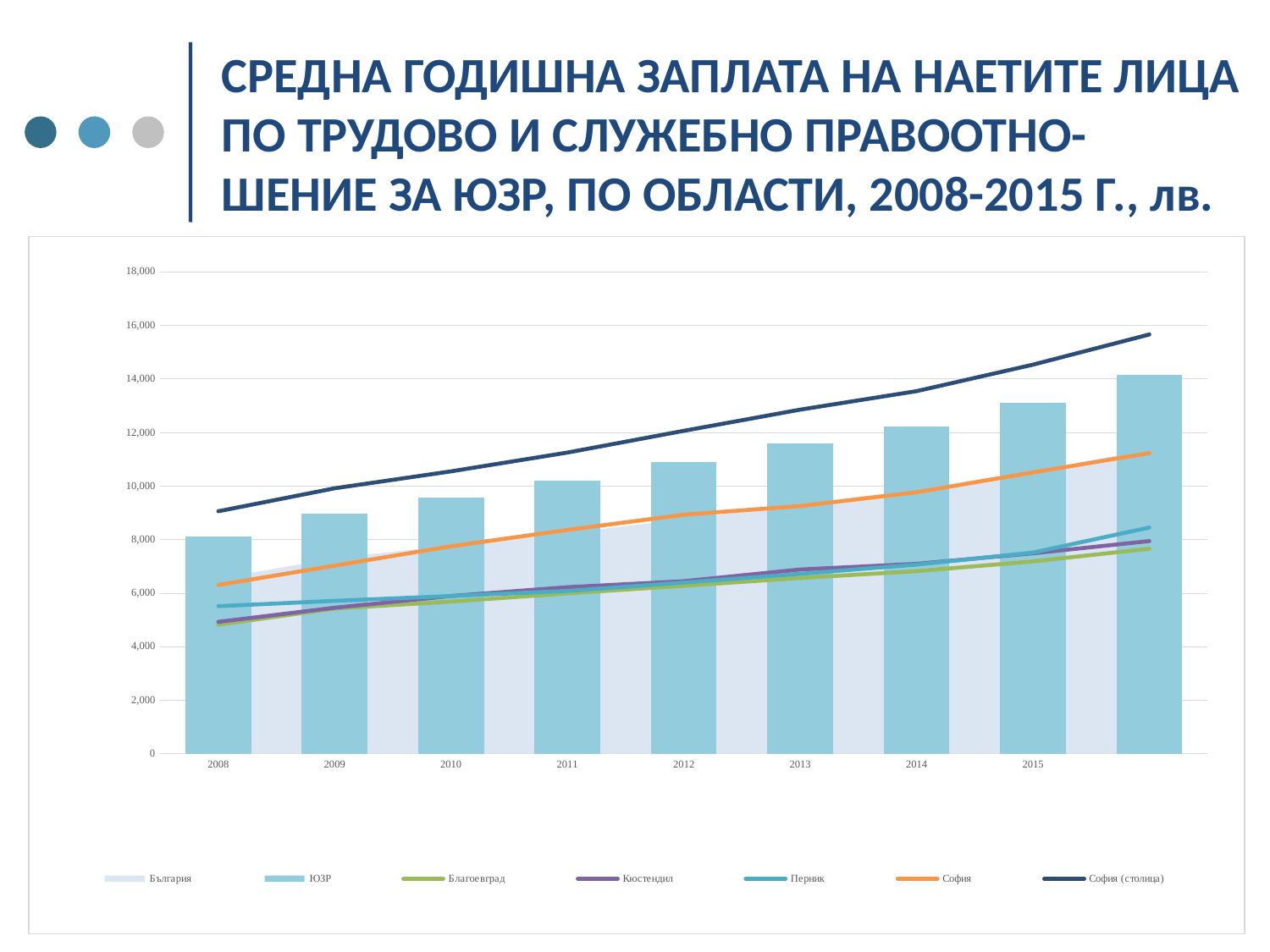
What colour is the София line? Orange How many series does the legend list? 7 Is the ЮЗР value for 2008 greater or less than 10,000? less What kind of chart is this? A combined bar and line chart (with an area series) What is the highest value shown on the y axis? 18,000 Do the ЮЗР bars rise or fall along the x axis? Rise In 2008, which is larger: the value for София or the value for Перник? София Is the ЮЗР value for 2012 greater or less than 10,000? greater Which series has the highest values across all years? София (столица) Is the value for София (столица) in 2015 greater or less than 12,000? greater Do the values for София (столица) rise or fall from 2008 to 2015? Rise